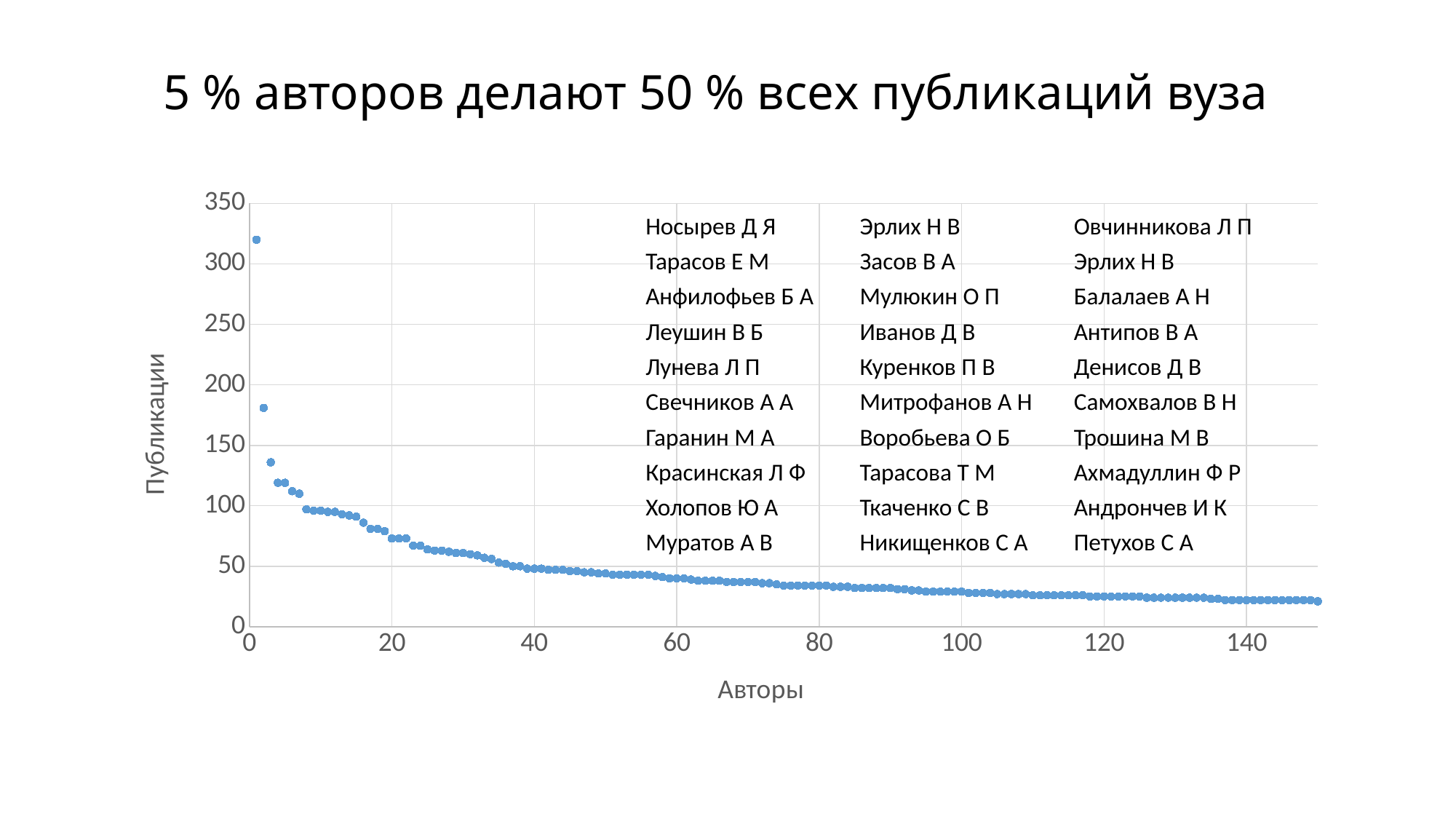
Is the value for the author at x = 140 greater or less than 50? less Is the value for the author at x = 60 greater or less than 50? less What is the title of the slide? 5 % авторов делают 50 % всех публикаций вуза What kind of chart is shown on the slide? scatter chart Is the value for the author at x = 20 greater or less than 100? less At which x position is the highest value plotted? 1 Do the values rise or fall as you move along the x axis from left to right? fall What is the label of the vertical axis? Публикации